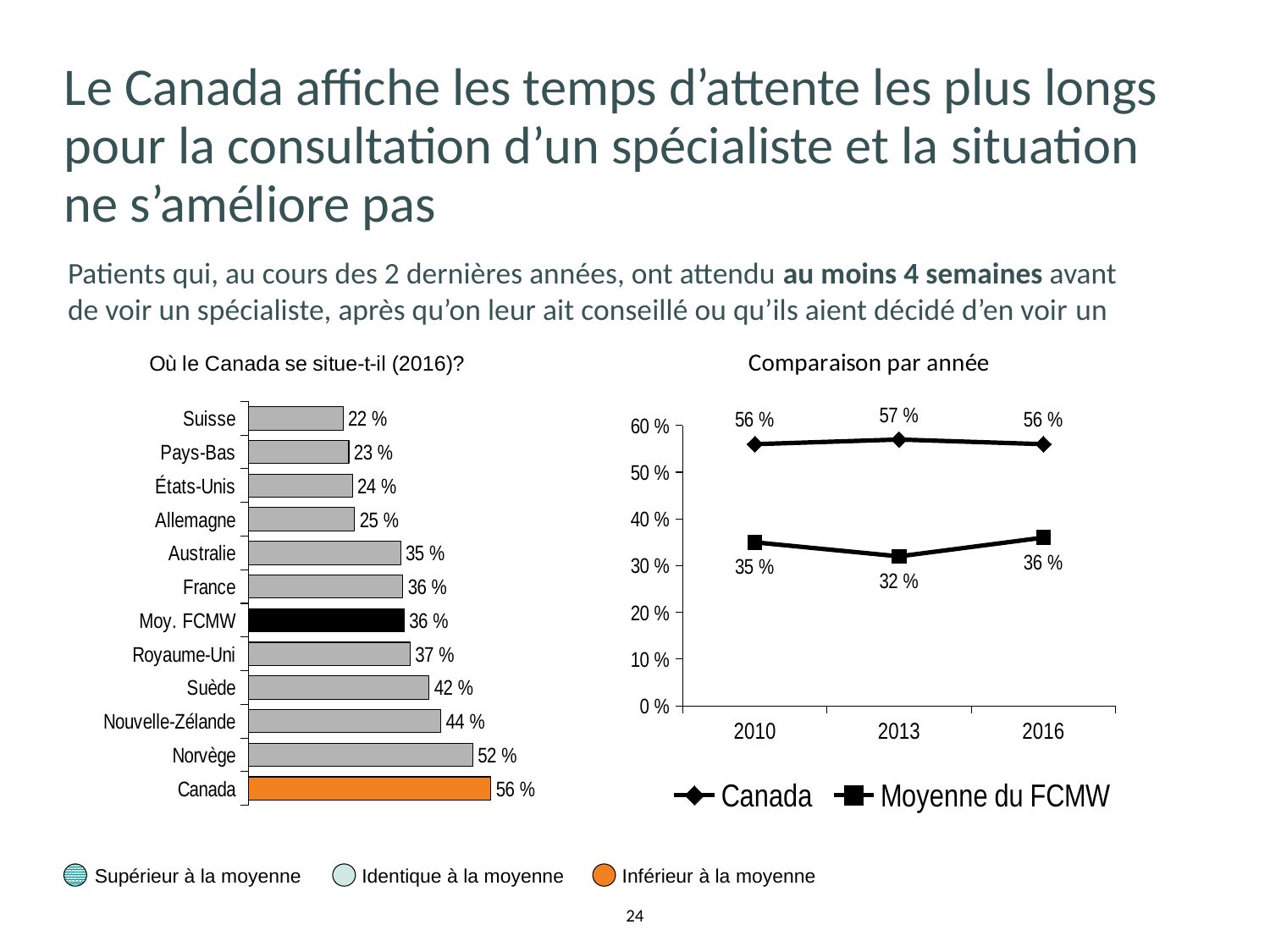
How many countries or categories are shown in the chart 'Où le Canada se situe-t-il (2016)?'? 12 In the chart 'Comparaison par année', what is the difference between Canada and Moyenne du FCMW in 2016? 20 % In the chart 'Comparaison par année', what is the value for Canada in 2013? 57 % In the chart 'Où le Canada se situe-t-il (2016)?', which is larger, the value for Suède or the value for Australie? Suède In the chart 'Où le Canada se situe-t-il (2016)?', what is the value for Norvège? 52 % What kind of chart is 'Où le Canada se situe-t-il (2016)?'? Bar chart In the chart 'Comparaison par année', what is the value for Moyenne du FCMW in 2013? 32 % In the chart 'Où le Canada se situe-t-il (2016)?', which country has the highest value? Canada In the chart 'Où le Canada se situe-t-il (2016)?', which country has the lowest value? Suisse In the chart 'Où le Canada se situe-t-il (2016)?', what is the value for Moy. FCMW? 36 % In the chart 'Où le Canada se situe-t-il (2016)?', what is the difference between the values for Canada and Suisse? 34 % How many series does the legend of the chart 'Comparaison par année' list? 2